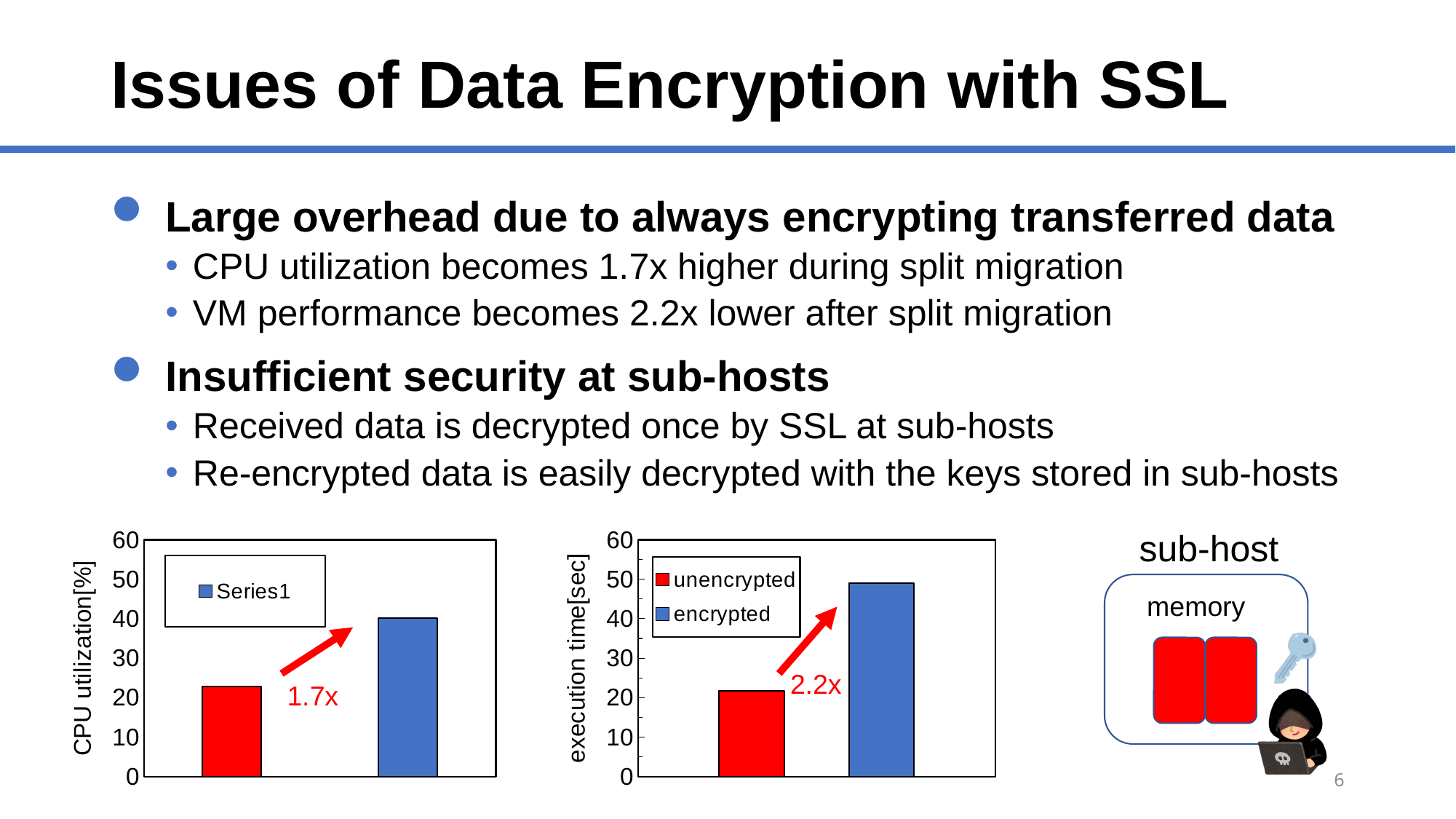
What kind of chart is the left chart with the y-axis labelled CPU utilization[%]? bar chart In the right chart (execution time[sec]), what are the legend entries? unencrypted, encrypted In the left chart (CPU utilization[%]), is the value of the red bar greater or less than 30? less In the right chart (execution time[sec]), how many series does the legend list? 2 In the left chart (CPU utilization[%]), what is the only legend entry? Series1 In the right chart (execution time[sec]), is the value for encrypted greater or less than 40? greater In the right chart (execution time[sec]), which series has the higher value, unencrypted or encrypted? encrypted In the left chart (CPU utilization[%]), how many bars are plotted? 2 What kind of chart is the right chart with the y-axis labelled execution time[sec]? bar chart In the right chart (execution time[sec]), how many bars are plotted? 2 In the left chart (CPU utilization[%]), which bar is taller, the red bar or the blue bar? the blue bar In the right chart (execution time[sec]), is the value for unencrypted greater or less than 30? less